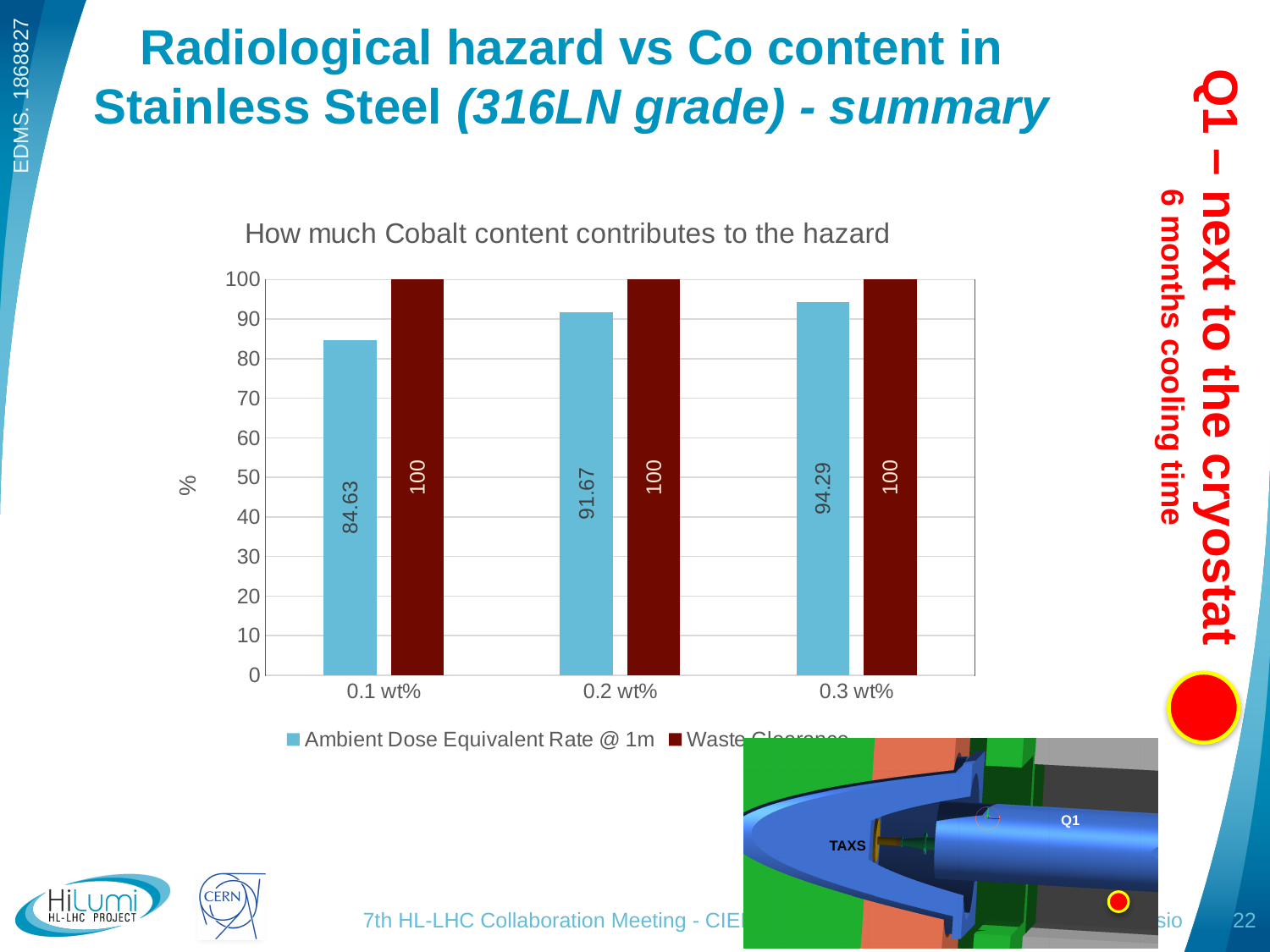
Does the Ambient Dose Equivalent Rate @ 1m value rise or fall as cobalt content increases from 0.1 wt% to 0.3 wt%? Rise What is the value of Ambient Dose Equivalent Rate @ 1m at 0.2 wt%? 91.67 Which cobalt content category has the highest Ambient Dose Equivalent Rate @ 1m value? 0.3 wt% How many cobalt content categories are shown on the x axis? 3 What kind of chart is shown on the slide? Bar chart At 0.1 wt%, which series has the larger value: Ambient Dose Equivalent Rate @ 1m or the dark red series? The dark red series What is the value of Ambient Dose Equivalent Rate @ 1m at 0.1 wt%? 84.63 How many series does the legend list? 2 What is the value of Ambient Dose Equivalent Rate @ 1m at 0.3 wt%? 94.29 What is the value of the dark red series at 0.2 wt%? 100 What is the difference between the Ambient Dose Equivalent Rate @ 1m values at 0.3 wt% and 0.1 wt%? 9.66 Which cobalt content category has the lowest Ambient Dose Equivalent Rate @ 1m value? 0.1 wt%